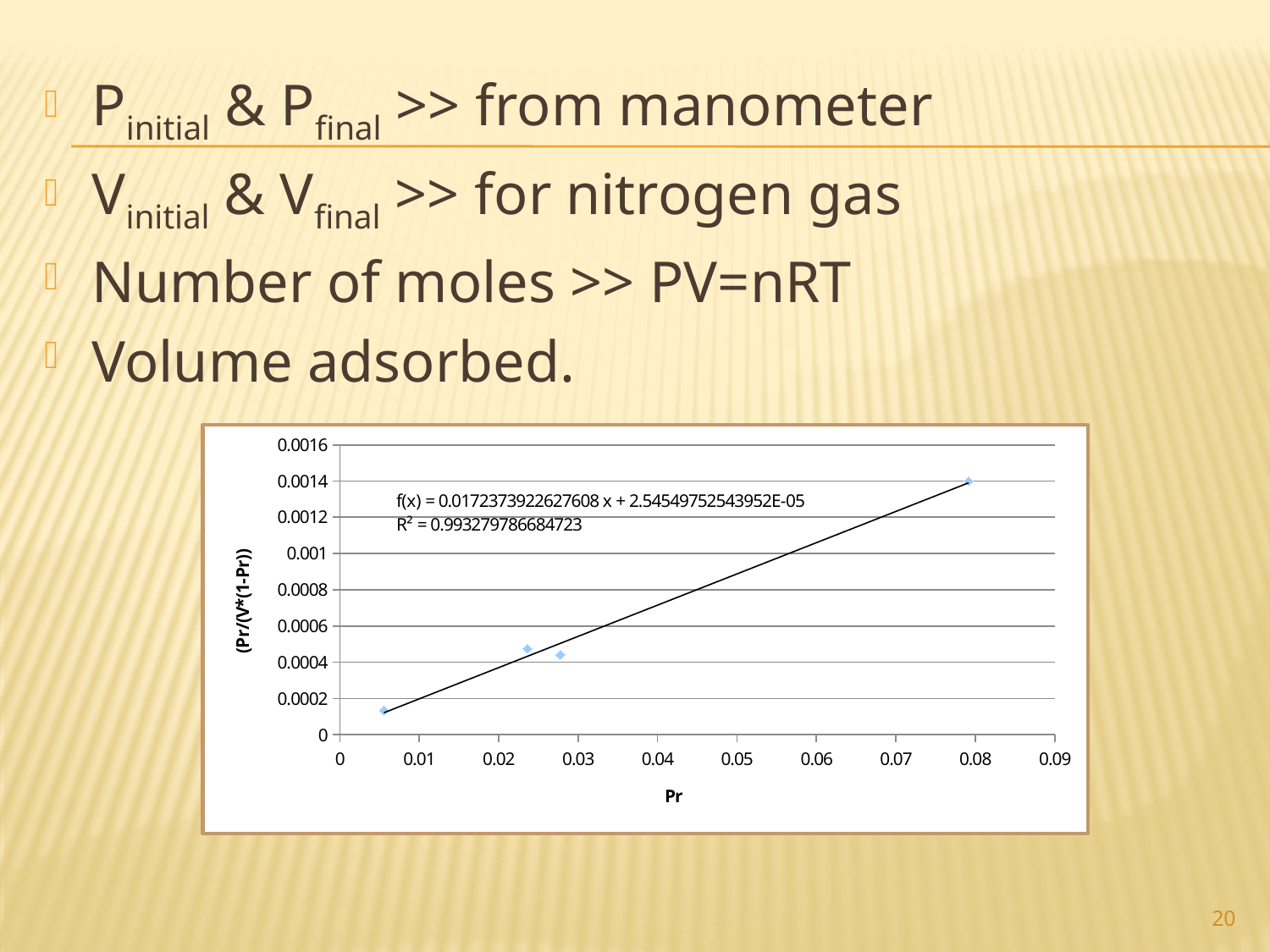
What kind of chart is shown on the slide? Scatter chart What is the slope of the trendline equation printed on the chart? 0.0172373922627608 Do the plotted values rise or fall as Pr increases along the x axis? Rise Is the y value of the data point near Pr = 0.024 greater or less than 0.0006? less What is the highest value shown on the y axis of the chart? 0.0016 What R² value is printed on the chart for the trendline? 0.993279786684723 Is the y value of the rightmost data point (near Pr = 0.08) greater or less than 0.0012? greater What is the intercept of the trendline equation printed on the chart? 2.54549752543952E-05 Is the y value of the leftmost data point (near Pr = 0.005) greater or less than 0.0002? less What is the title of the y axis of the chart? (Pr/(V*(1-Pr)) How many data points are plotted in the chart? 4 What is the title of the x axis of the chart? Pr